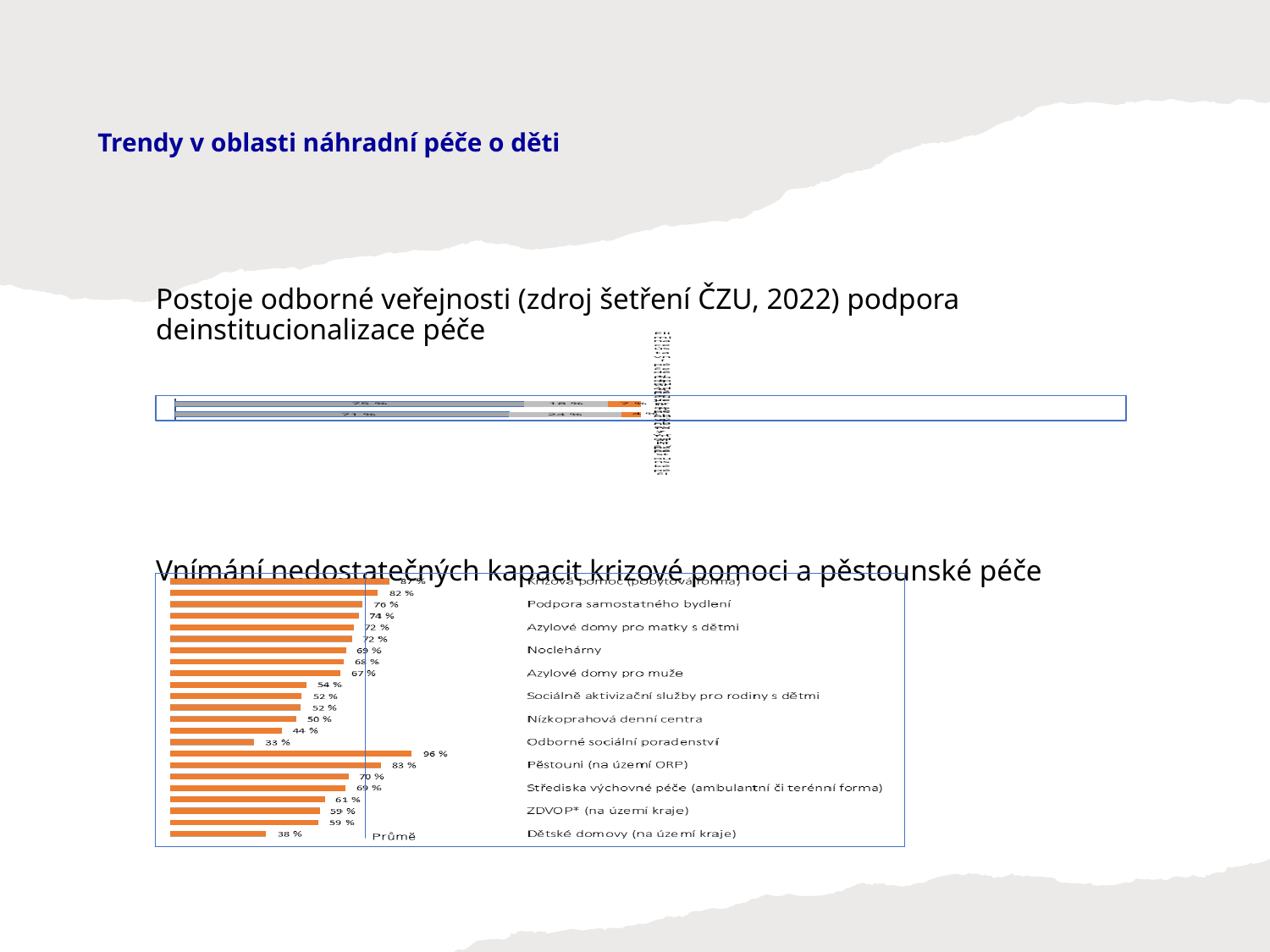
In the bottom chart, which is larger: the bar labelled 96 % or the bar labelled 87 %? 96 % In the top chart, what is the difference between the blue segment of the upper bar (75 %) and the blue segment of the lower bar (71 %)? 4 % In the top chart, what is the value of the blue segment of the upper bar? 75 % In the bottom chart, what is the difference between the highest bar value (96 %) and the lowest bar value (33 %)? 63 % In the bottom chart, what colour are the bars? orange What kind of chart is the bottom chart titled 'Vnímání nedostatečných kapacit krizové pomoci a pěstounské péče'? bar chart In the bottom chart, what is the highest value shown on any bar? 96 % In the bottom chart, what is the lowest value shown on any bar? 33 % What kind of chart is the top chart below the heading 'Postoje odborné veřejnosti'? bar chart In the top chart, which is larger: the blue segment of the upper bar (75 %) or the blue segment of the lower bar (71 %)? upper bar (75 %) In the top chart, how many stacked bars are plotted? 2 In the top chart, what is the value of the blue segment of the lower bar? 71 %